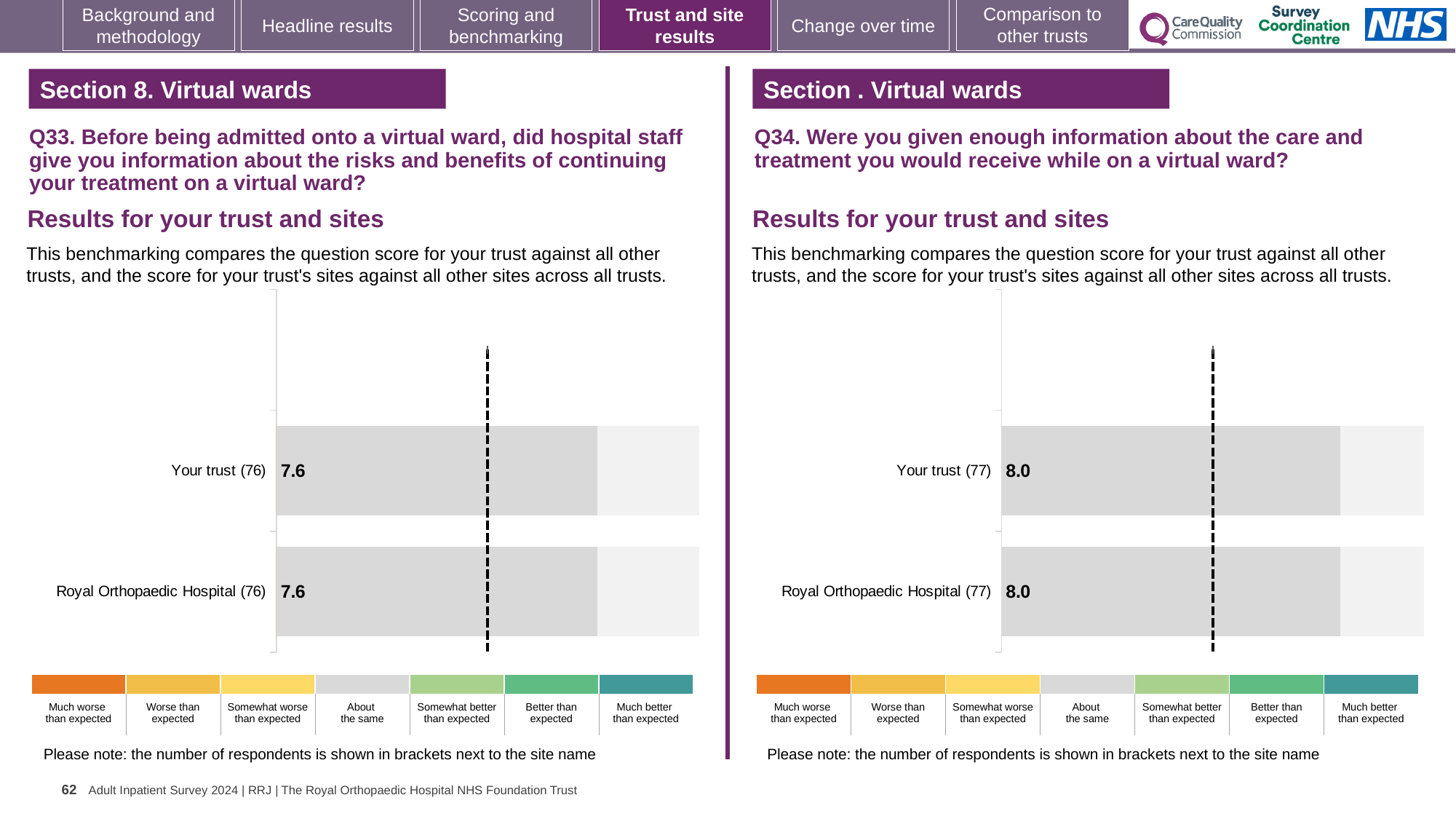
In the Q33 chart on the left, what is the difference between the score for Your trust and the score for Royal Orthopaedic Hospital? 0.0 What kind of chart is the Q34 chart on the right? Bar chart In the Q33 chart on the left, how many respondents are shown in brackets for Your trust? 76 In the Q34 chart on the right, what is the score for Your trust? 8.0 In the Q33 chart on the left, what is the score for Royal Orthopaedic Hospital? 7.6 How many bars are plotted in the Q34 chart on the right? 2 How many bars are plotted in the Q33 chart on the left? 2 In the Q34 chart on the right, how many respondents are shown in brackets for Royal Orthopaedic Hospital? 77 In the Q33 chart on the left, what is the score for Your trust? 7.6 In the Q34 chart on the right, what is the difference between the score for Your trust and the score for Royal Orthopaedic Hospital? 0.0 In the Q33 chart on the left, which benchmark category does the grey colour of the bars correspond to in the key below the chart? About the same In the Q34 chart on the right, what is the score for Royal Orthopaedic Hospital? 8.0